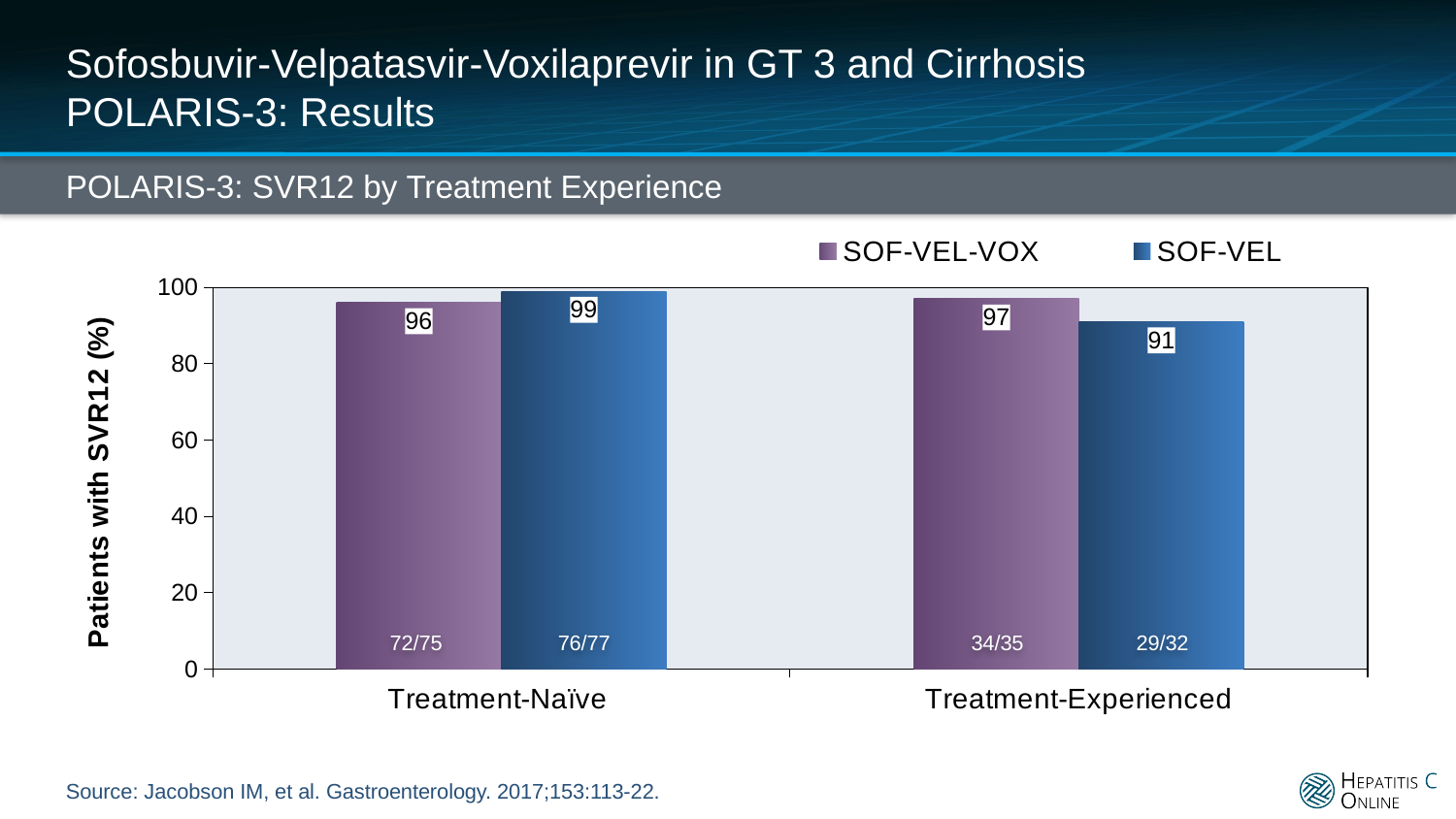
What is the SVR12 value for SOF-VEL-VOX in the Treatment-Experienced group? 97 In the Treatment-Naïve group, which series has the larger SVR12 value, SOF-VEL-VOX or SOF-VEL? SOF-VEL What is the SVR12 value for SOF-VEL in the Treatment-Naïve group? 99 What fraction of patients is shown for SOF-VEL in the Treatment-Experienced group? 29/32 How many series does the legend list? 2 Which bar has the lowest SVR12 value on the chart? SOF-VEL, Treatment-Experienced What is the difference between the SOF-VEL-VOX and SOF-VEL values in the Treatment-Experienced group? 6 What kind of chart is shown on the slide? Bar chart What is the label of the y axis? Patients with SVR12 (%) What is the SVR12 value for SOF-VEL in the Treatment-Experienced group? 91 How many categories are shown on the x axis? 2 What is the SVR12 value for SOF-VEL-VOX in the Treatment-Naïve group? 96